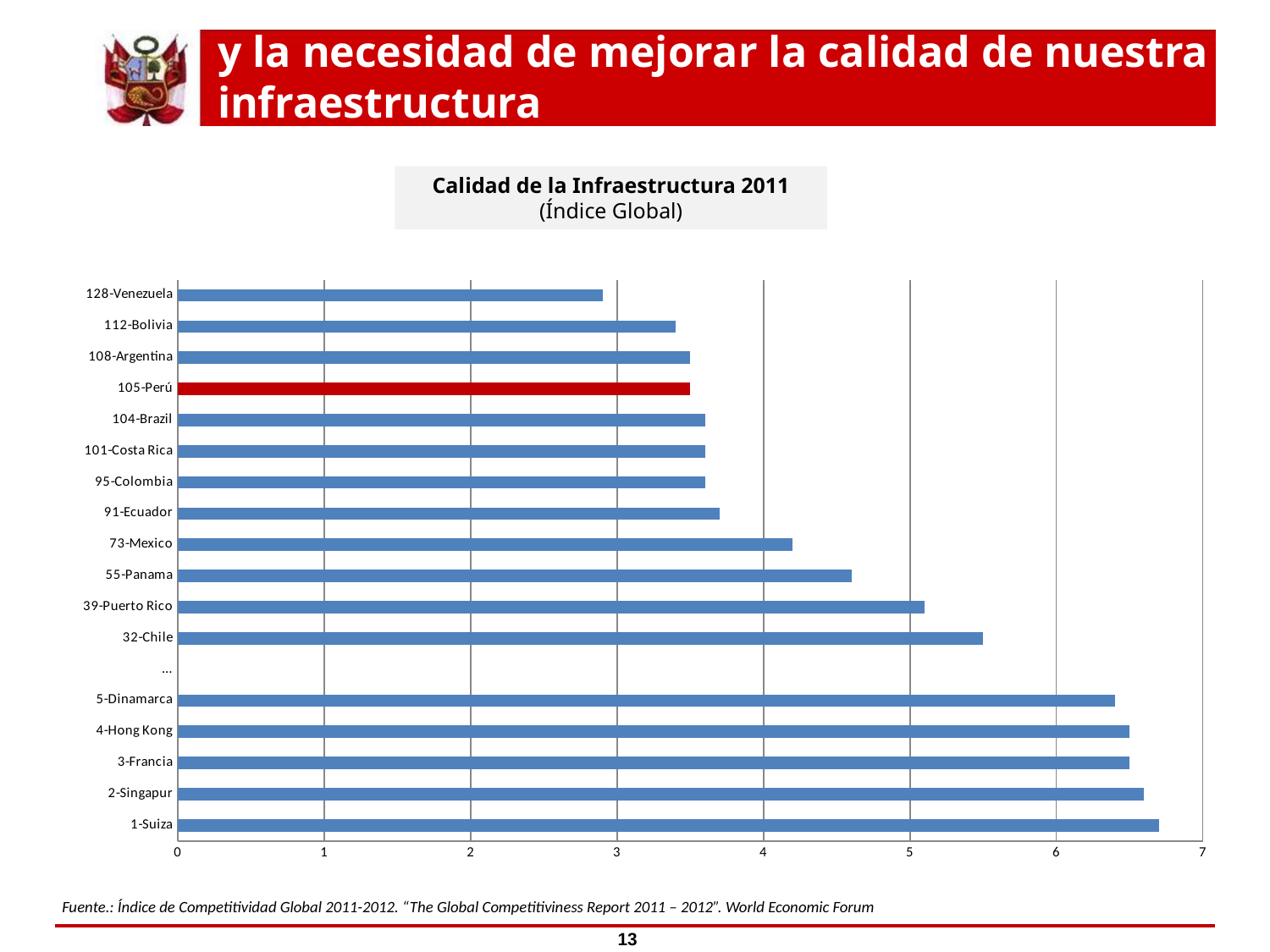
Which country's bar is coloured red instead of blue? 105-Perú Is the value for 32-Chile greater or less than 5? greater Which country has the lowest infrastructure quality index in the chart? 128-Venezuela Is the value for 1-Suiza greater or less than 6? greater Which has a higher value, 73-Mexico or 105-Perú? 73-Mexico What kind of chart is shown on the slide? bar chart Which country has the highest infrastructure quality index in the chart? 1-Suiza Is the value for 128-Venezuela greater or less than 3? less Which has a higher value, 32-Chile or 55-Panama? 32-Chile